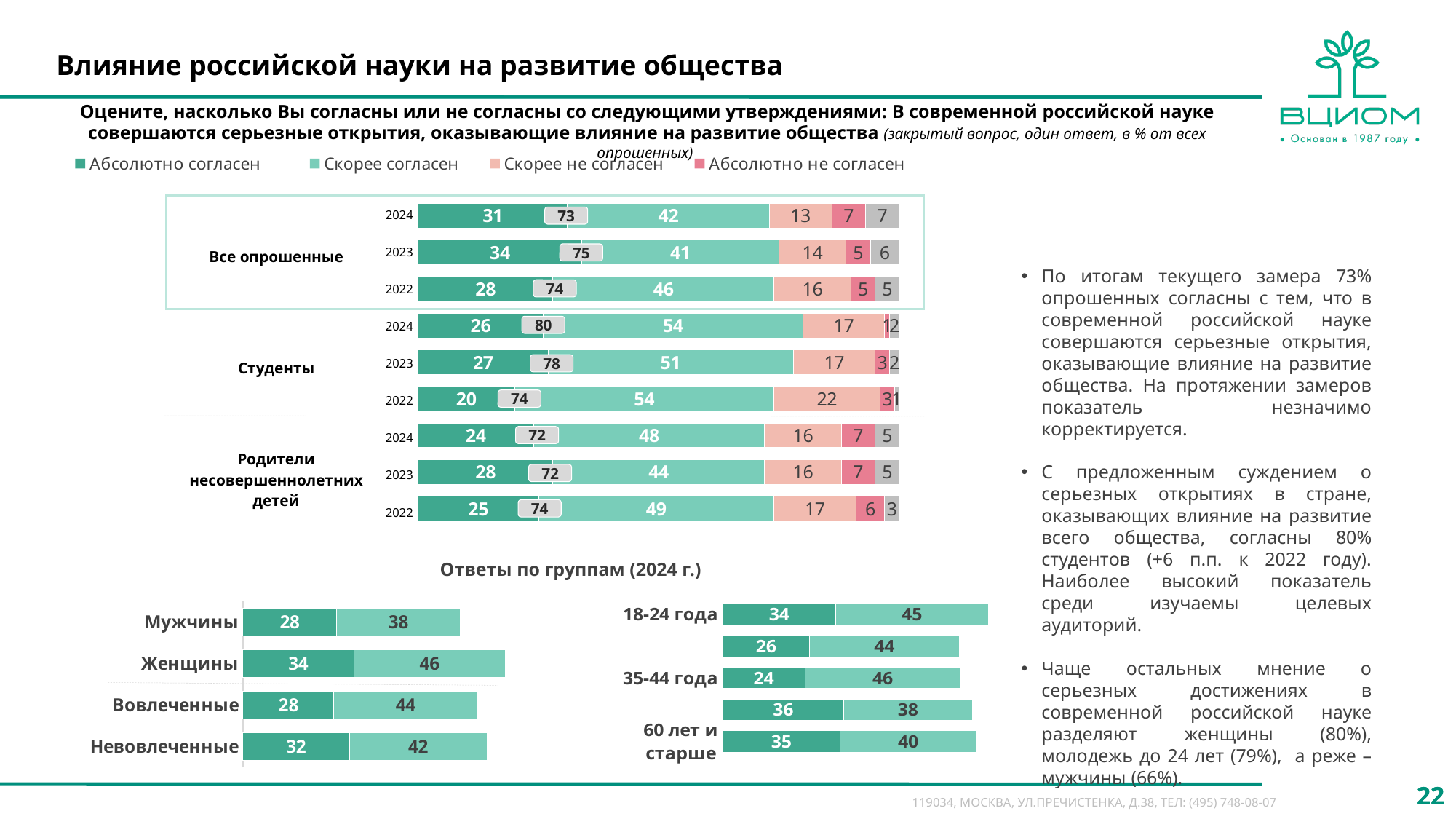
In the bottom-left chart, what is the total of the two segments for 'Женщины'? 80 In the bottom-left chart 'Ответы по группам (2024 г.)', which has the larger 'Скорее согласен' value: Мужчины or Женщины? Женщины What kind of chart is the top chart on the slide? Stacked bar chart In the bottom-left chart, which category has the lowest 'Скорее согласен' value? Мужчины How many categories are shown in the bottom-left chart? 4 In the bottom-right chart, what is the 'Скорее согласен' value for '60 лет и старше'? 40 In the top stacked bar chart, what is the difference between 'Скорее согласен' and 'Абсолютно согласен' for 'Все опрошенные' in 2024? 11 In the bottom-left chart, what is the 'Абсолютно согласен' value for 'Невовлеченные'? 32 How many series does the legend of the top chart list? 4 In the top stacked bar chart, in which year is 'Абсолютно согласен' highest for 'Все опрошенные'? 2023 In the top stacked bar chart, what is the value of 'Скорее согласен' for 'Студенты' in 2024? 54 In the top stacked bar chart, what is the value of 'Абсолютно согласен' for 'Все опрошенные' in 2024? 31